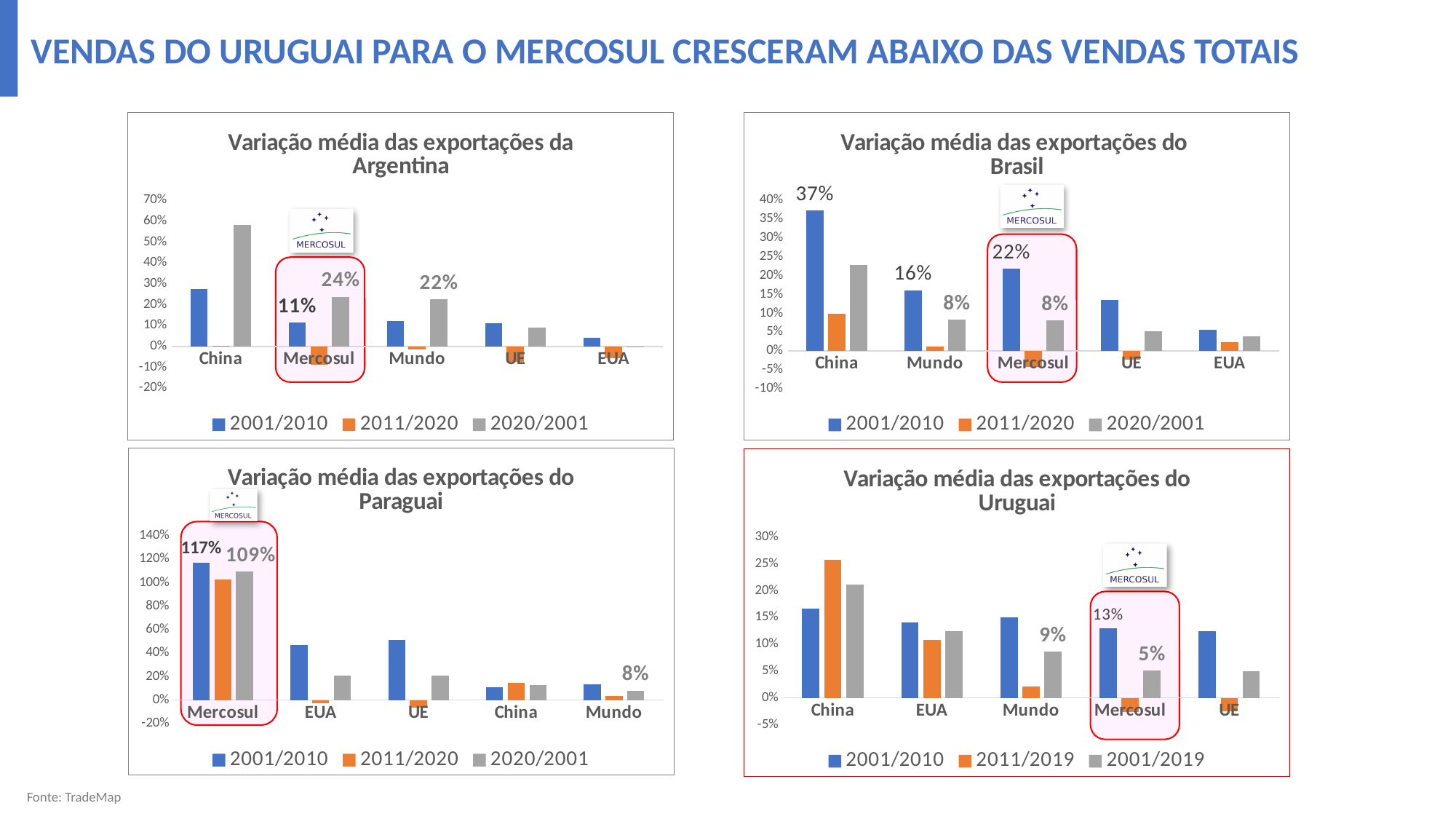
In the chart 'Variação média das exportações do Uruguai', what is the value for Mercosul in the 2001/2019 series? 5% How many categories are shown on the x axis of the chart 'Variação média das exportações do Uruguai'? 5 In the chart 'Variação média das exportações do Paraguai', what is the difference between the 2001/2010 and 2020/2001 values for Mercosul? 8% How many series does the legend of the chart 'Variação média das exportações do Paraguai' list? 3 In the chart 'Variação média das exportações do Paraguai', what is the value for Mercosul in the 2020/2001 series? 109% In the chart 'Variação média das exportações da Argentina', what is the value for Mercosul in the 2001/2010 series? 11% In the chart 'Variação média das exportações do Brasil', what is the difference between the 2001/2010 and 2020/2001 values for Mercosul? 14% In the chart 'Variação média das exportações do Brasil', which category has the highest 2001/2010 value? China In the chart 'Variação média das exportações do Brasil', what is the value for China in the 2001/2010 series? 37% In the chart 'Variação média das exportações da Argentina', is the 2020/2001 value for China greater or less than 50%? greater What kind of chart is 'Variação média das exportações do Uruguai'? bar chart In the chart 'Variação média das exportações do Uruguai', which has the larger 2001/2019 value, Mundo or Mercosul? Mundo